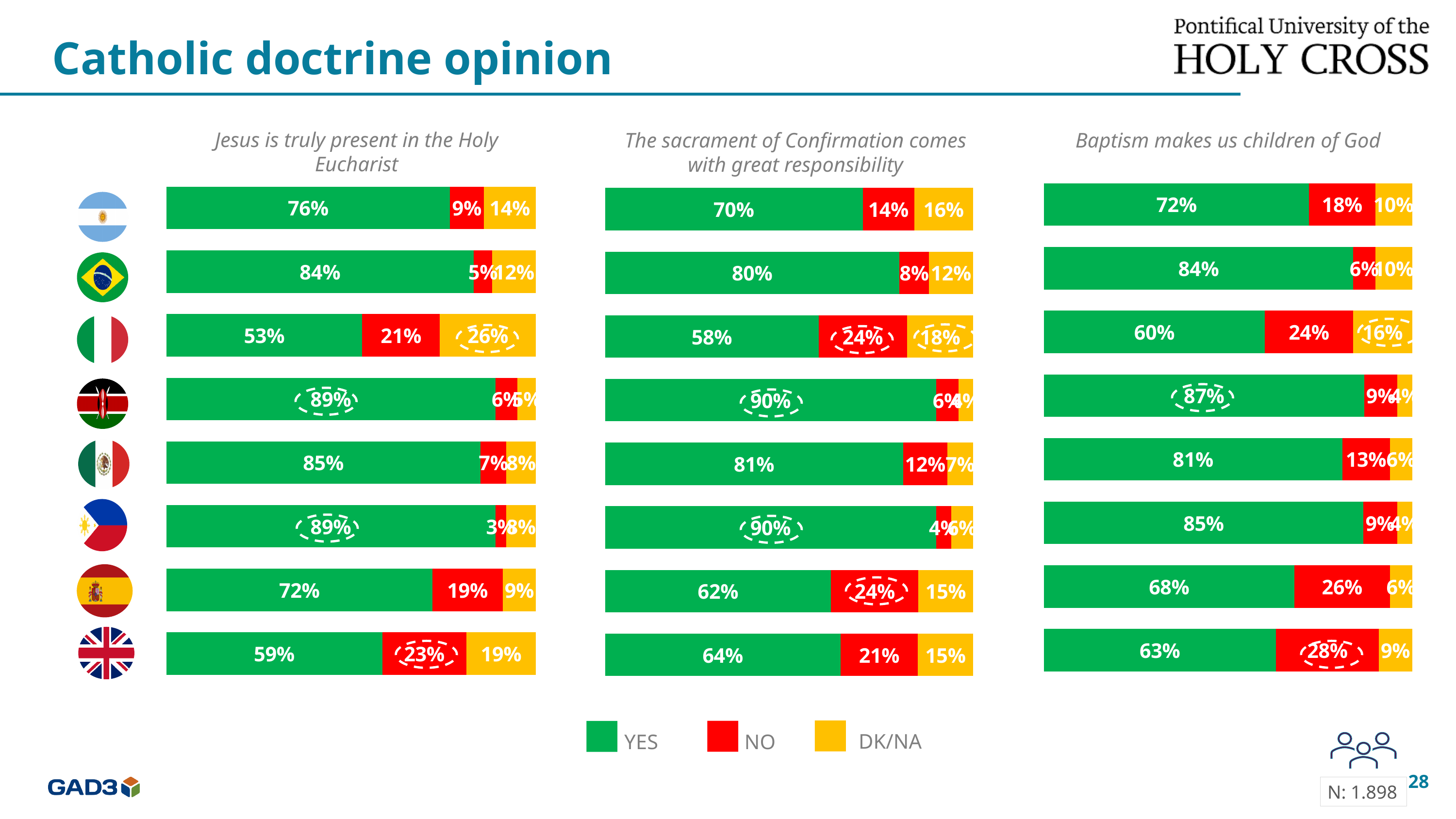
In the chart titled 'Baptism makes us children of God', what is the DK/NA value for the third row (Italian flag)? 16% In the chart titled 'Jesus is truly present in the Holy Eucharist', what is the YES value for the third row (Italian flag)? 53% How many country rows does each chart on the slide show? 8 In the chart titled 'Baptism makes us children of God', what is the total of the YES, NO and DK/NA segments for the row with the Spanish flag? 100% In the chart titled 'Baptism makes us children of God', which row has the highest NO value? The last row (UK flag), 28% In the chart titled 'The sacrament of Confirmation comes with great responsibility', what is the NO value for the last row (UK flag)? 21% In the chart titled 'Jesus is truly present in the Holy Eucharist', which row has the lowest YES value? The third row (Italian flag), 53% In the chart titled 'Baptism makes us children of God', which row has the highest YES value? The fourth row (Kenyan flag), 87% In the chart titled 'The sacrament of Confirmation comes with great responsibility', how much higher is the YES value for the second row (Brazilian flag) than for the first row (Argentine flag)? 10 percentage points In the chart titled 'Jesus is truly present in the Holy Eucharist', which has the larger YES value: the row with the Spanish flag or the row with the UK flag? The row with the Spanish flag (72%) What kind of chart is used on this slide? Stacked bar chart How many series does the legend list? 3